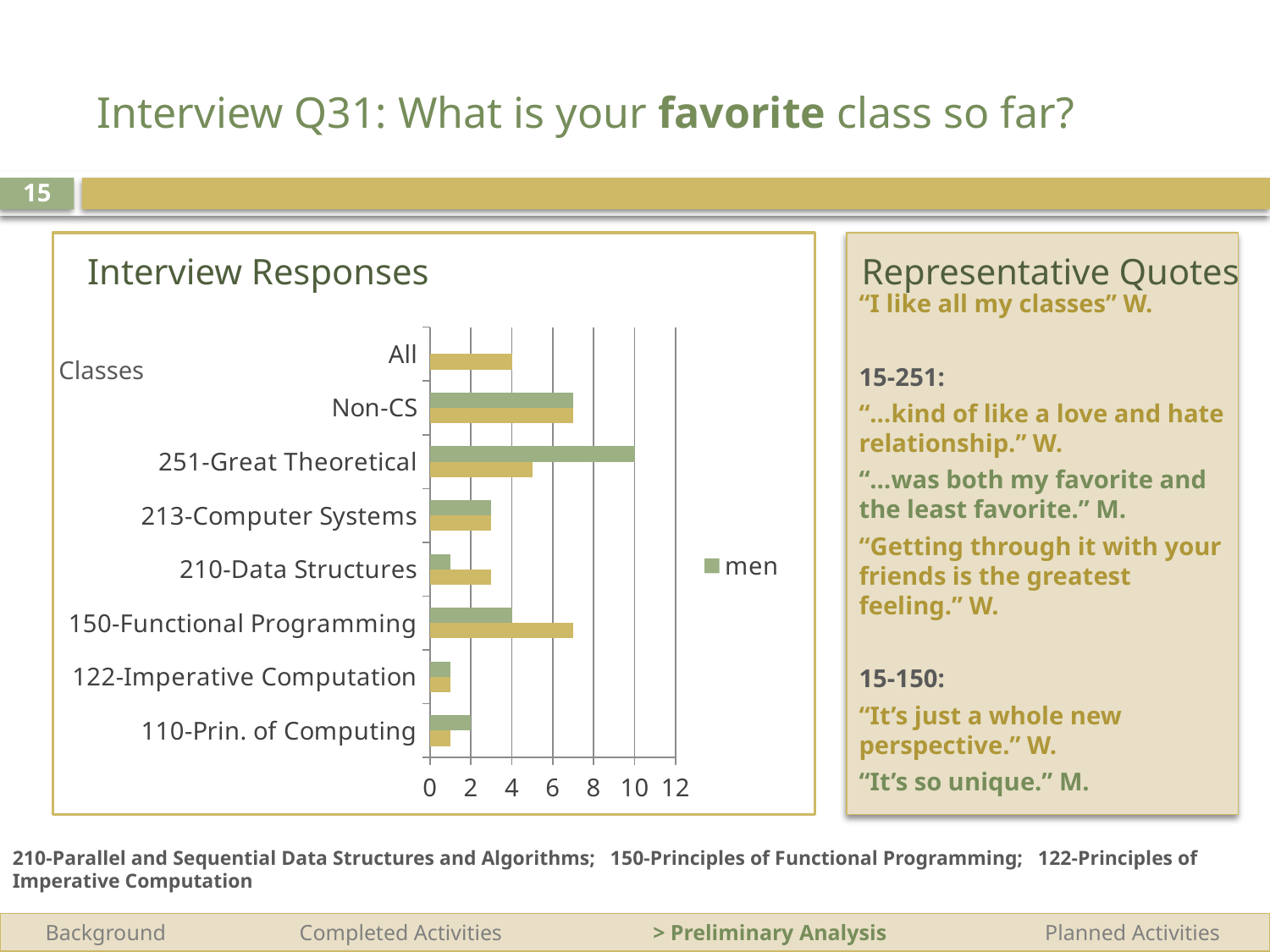
What is the value for men for 110-Prin. of Computing in the Interview Responses chart? 2 For the men series, which is larger: 150-Functional Programming or 210-Data Structures? 150-Functional Programming How many classes (categories) are listed on the vertical axis of the Interview Responses chart? 8 For the men series, which is larger: 251-Great Theoretical or Non-CS? 251-Great Theoretical What kind of chart is shown under the title "Interview Responses"? bar chart Which category has the highest value for the men series in the Interview Responses chart? 251-Great Theoretical Is the value for men for 213-Computer Systems greater or less than 4? less What series name is shown in the legend of the Interview Responses chart? men Is the value for men for 251-Great Theoretical greater or less than 8? greater Is the value for men for Non-CS greater or less than 6? greater What is the value for men for 251-Great Theoretical in the Interview Responses chart? 10 What is the title of the chart on the slide? Interview Responses